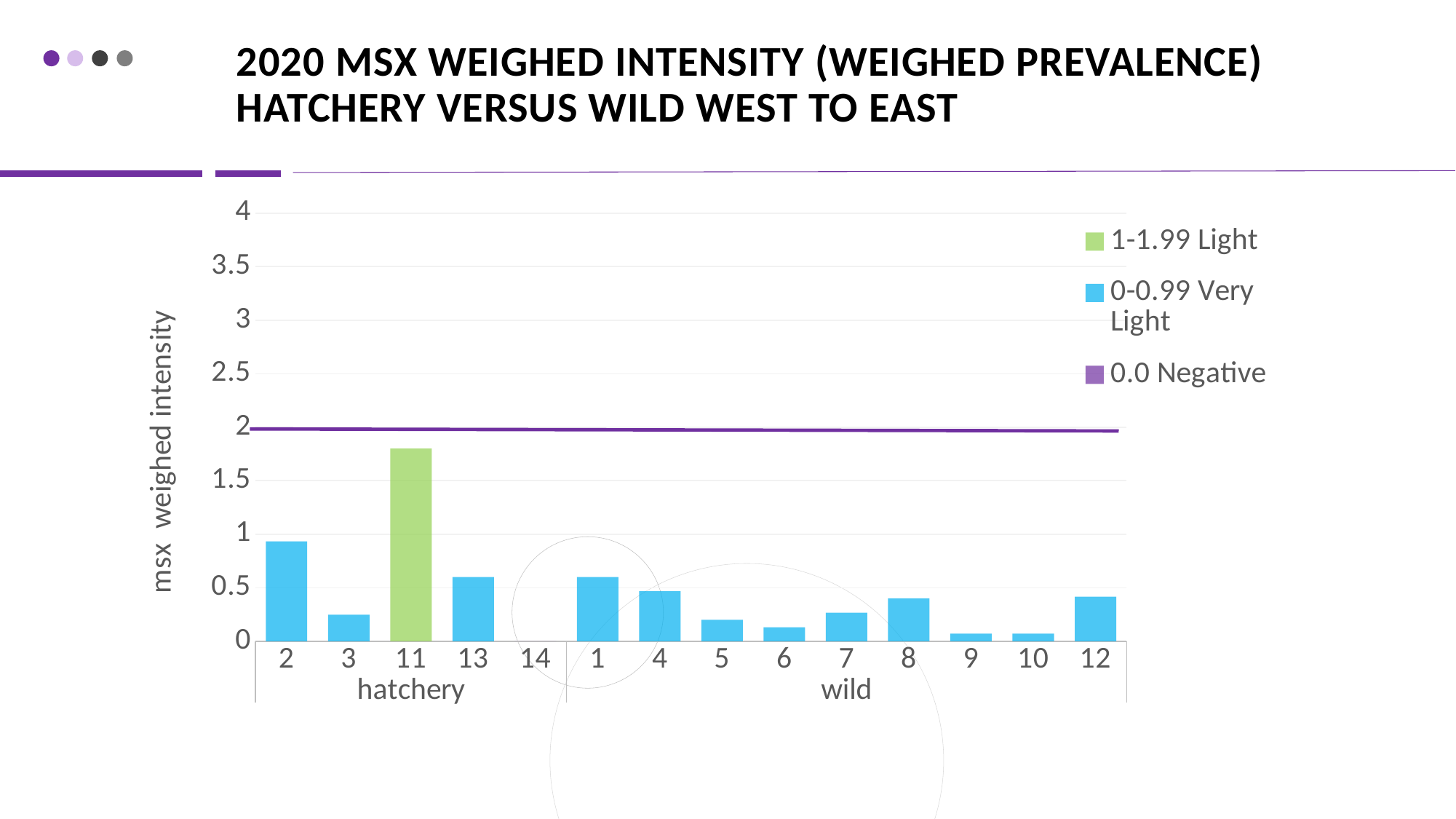
How many site categories are shown along the x axis? 14 Is the value for site 5 greater or less than 0.5? less How many entries does the legend list? 3 How many hatchery sites are shown on the x axis? 5 What kind of chart is shown on the slide? bar chart Which site has the highest msx weighed intensity? 11 What is the title of the y axis? msx weighed intensity Which has a larger value, site 11 or site 13? site 11 Which has a larger value, site 2 or site 3? site 2 Is the value for site 11 greater or less than 1.5? greater How many wild sites are shown on the x axis? 9 Is the value for site 2 greater or less than 1? less